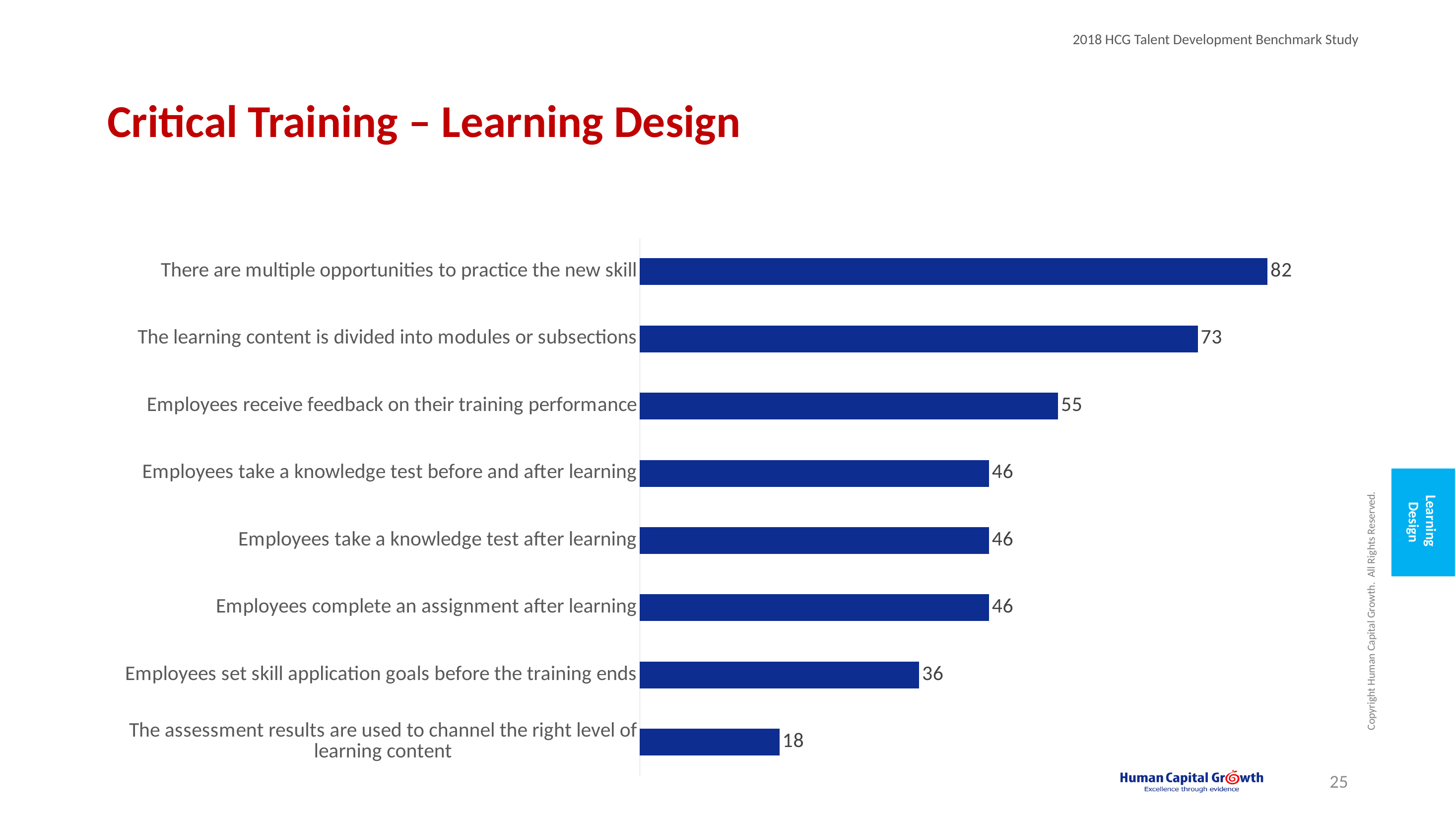
What kind of chart is shown on the slide? Bar chart Which category has the lowest value? The assessment results are used to channel the right level of learning content What is the value for "Employees set skill application goals before the training ends"? 36 What is the value for "The assessment results are used to channel the right level of learning content"? 18 What is the value for "Employees receive feedback on their training performance"? 55 What is the difference between the values for "Employees receive feedback on their training performance" and "Employees set skill application goals before the training ends"? 19 What is the title of the slide containing the chart? Critical Training – Learning Design What is the value for "There are multiple opportunities to practice the new skill"? 82 What is the difference between the values for "There are multiple opportunities to practice the new skill" and "The learning content is divided into modules or subsections"? 9 Which is larger: the value for "The learning content is divided into modules or subsections" or the value for "Employees take a knowledge test after learning"? The learning content is divided into modules or subsections How many categories are shown in the chart? 8 Which category has the highest value? There are multiple opportunities to practice the new skill